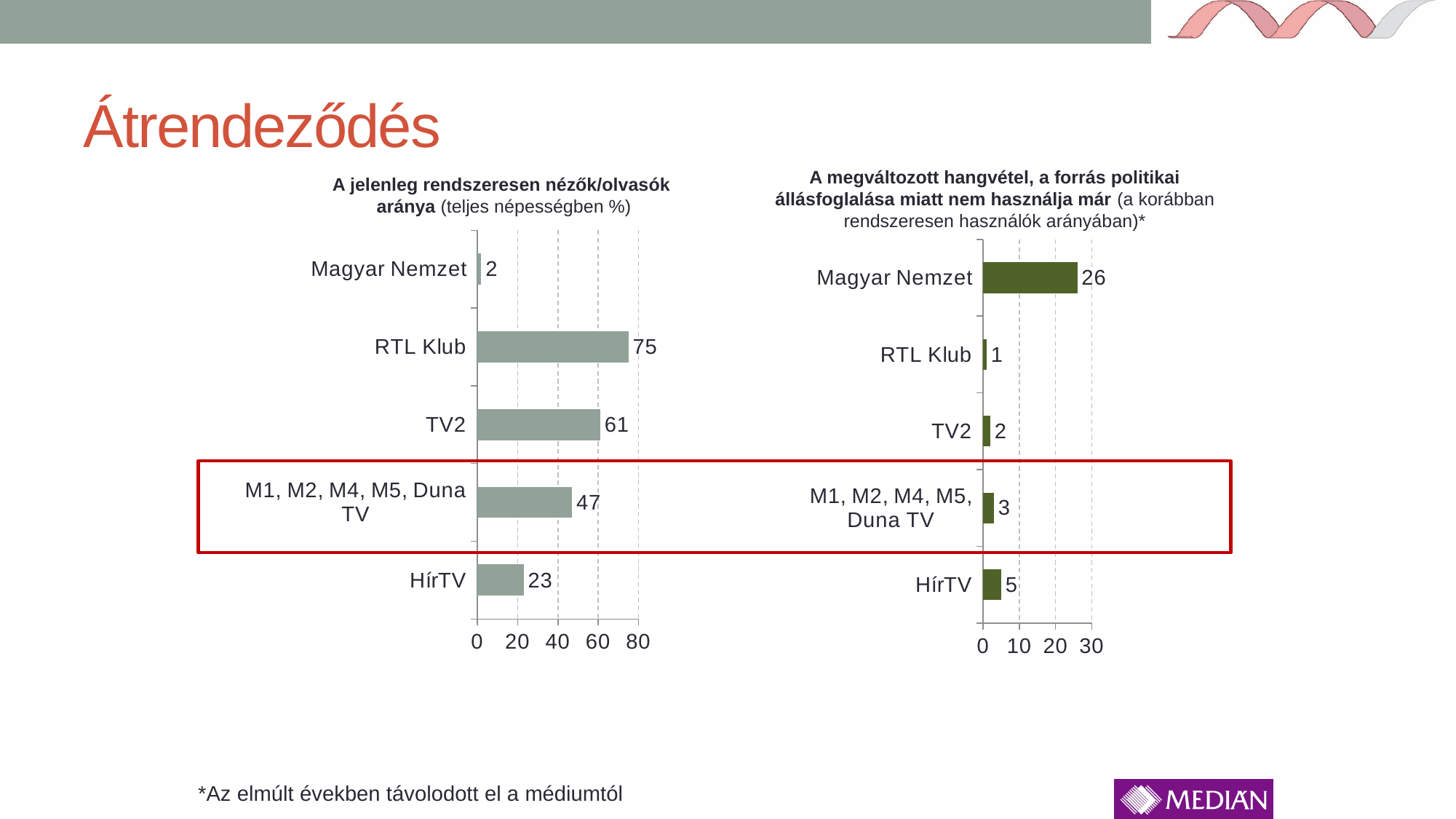
In the right chart, which category has the highest value? Magyar Nemzet In the left chart (A jelenleg rendszeresen nézők/olvasók aránya), what is the value for RTL Klub? 75 In the right chart (A megváltozott hangvétel...), what is the value for M1, M2, M4, M5, Duna TV? 3 In the left chart, what is the difference between the values for RTL Klub and TV2? 14 In the right chart, which category has the lowest value? RTL Klub In the left chart, which category has the highest value? RTL Klub In the right chart (A megváltozott hangvétel...), what is the value for Magyar Nemzet? 26 What type of chart is the right chart? Bar chart How many categories are shown in the left chart? 5 In the left chart, which category has the lowest value? Magyar Nemzet In the left chart (A jelenleg rendszeresen nézők/olvasók aránya), what is the value for HírTV? 23 In the right chart, which is larger: the value for HírTV or the value for TV2? HírTV